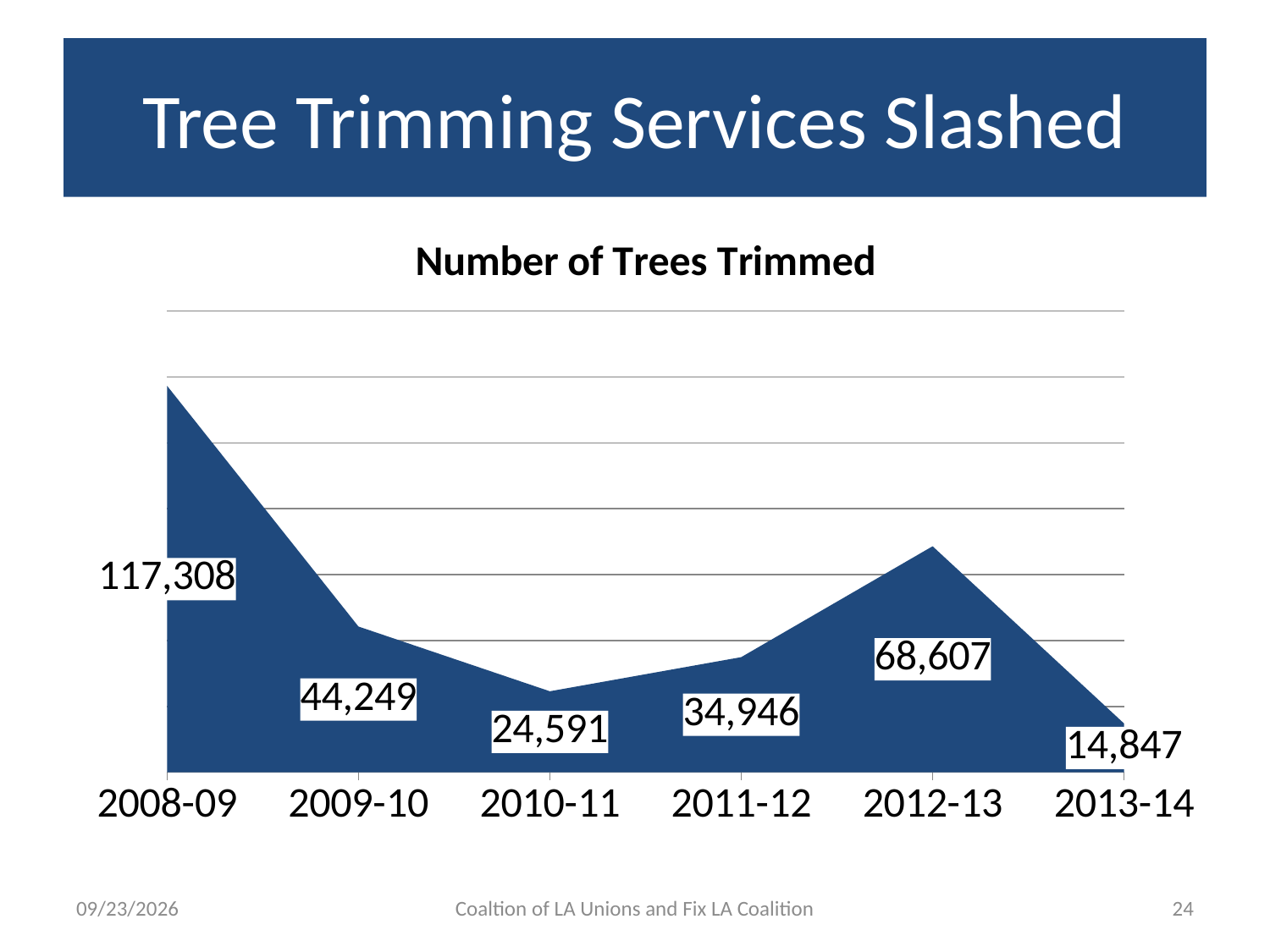
What kind of chart is shown on the slide? Area chart What is the difference in trees trimmed between 2012-13 and 2013-14? 53,760 Which year has the highest number of trees trimmed? 2008-09 Which year had more trees trimmed, 2011-12 or 2010-11? 2011-12 What is the number of trees trimmed in 2010-11? 24,591 What is the number of trees trimmed in 2008-09? 117,308 What is the number of trees trimmed in 2013-14? 14,847 How many fiscal years are shown on the x axis? 6 What is the difference in trees trimmed between 2008-09 and 2009-10? 73,059 What is the title of the chart? Number of Trees Trimmed Which year has the lowest number of trees trimmed? 2013-14 What is the number of trees trimmed in 2012-13? 68,607